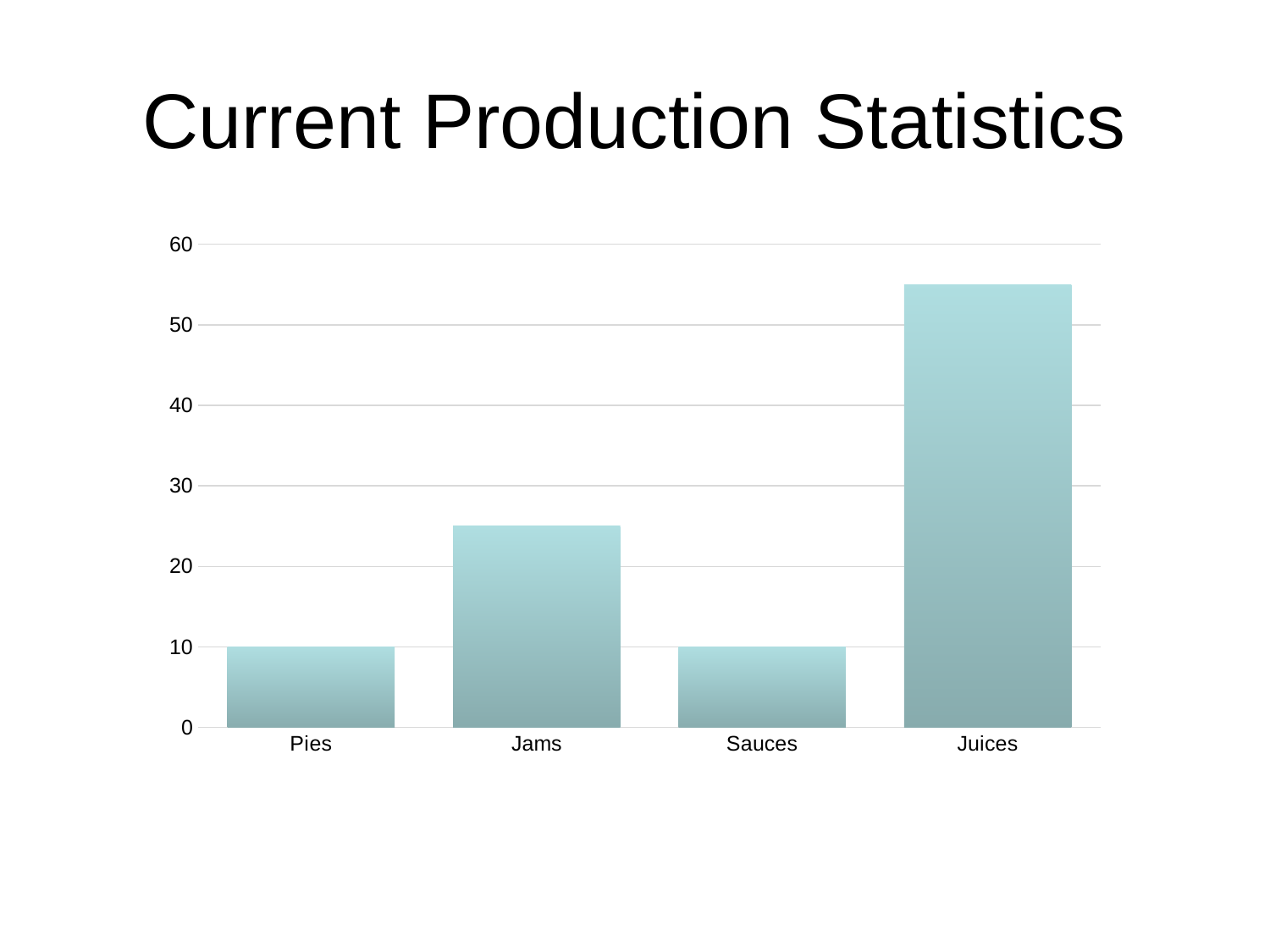
What kind of chart is shown on the slide? bar chart Is the value for Jams greater or less than 20? greater Is the value for Juices greater or less than 60? less Is the value for Jams greater or less than 30? less Which category has the highest value? Juices Which is larger, the value for Jams or the value for Pies? Jams What is the value for Pies? 10 How many categories are shown on the x axis of the chart? 4 What is the title of the slide containing the chart? Current Production Statistics Which is larger, the value for Juices or the value for Jams? Juices What is the value for Sauces? 10